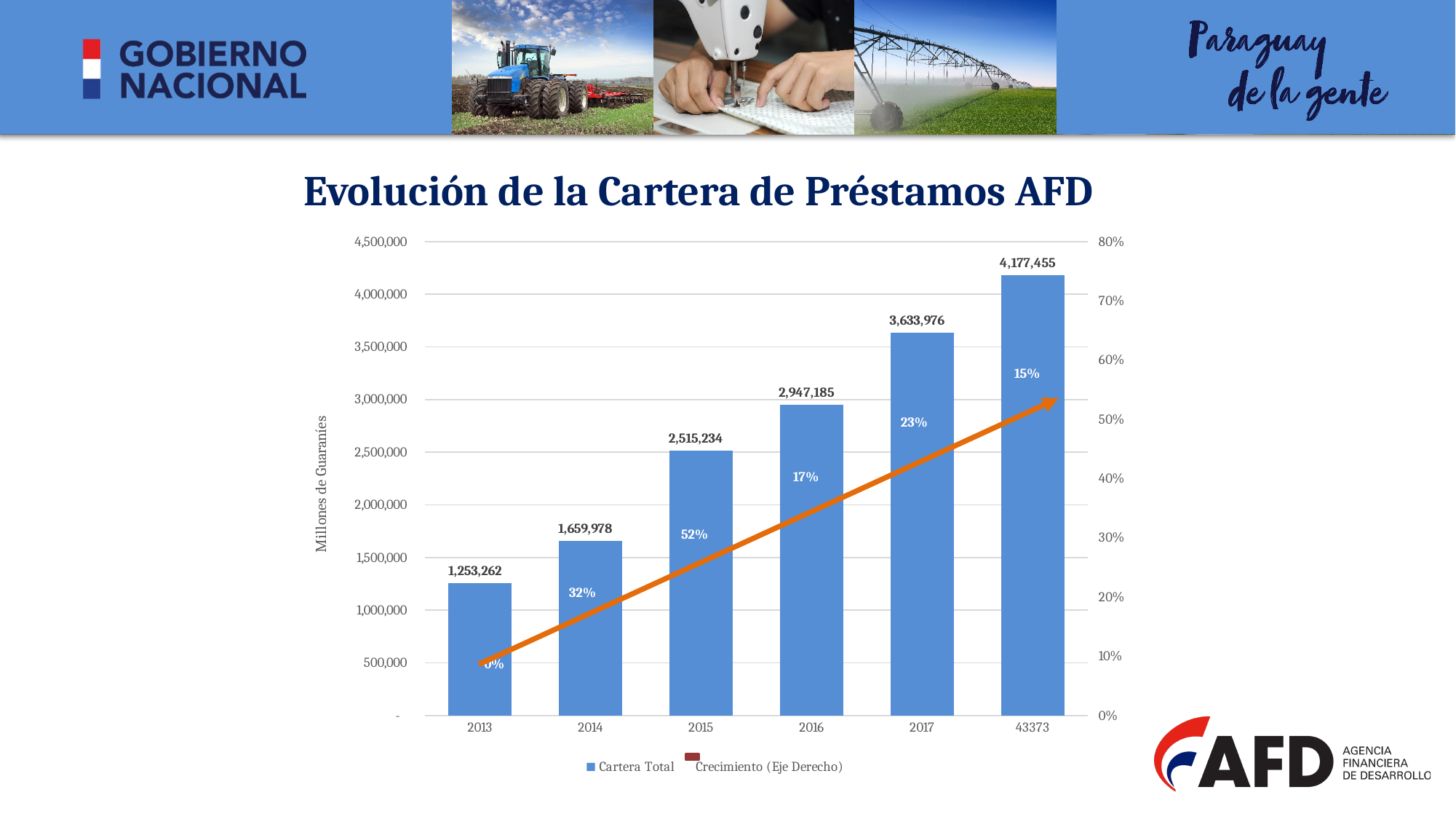
What is the difference between the Cartera Total values for 2017 and 2016? 686,791 Which year has the highest growth percentage shown on its bar? 2015 How many series does the legend list? 2 Do the Cartera Total values rise or fall from 2013 to the last category? Rise Which category has the highest Cartera Total value? 43373 Which year has the lowest Cartera Total value? 2013 How many bars are plotted in the chart? 6 What growth percentage (Crecimiento) is shown on the bar for 2014? 32% Which is larger, the Cartera Total for 2014 or for 2015? 2015 What kind of chart is shown on the slide? Combination bar and line chart What is the Cartera Total value for 2013? 1,253,262 What is the Cartera Total value for 2015? 2,515,234